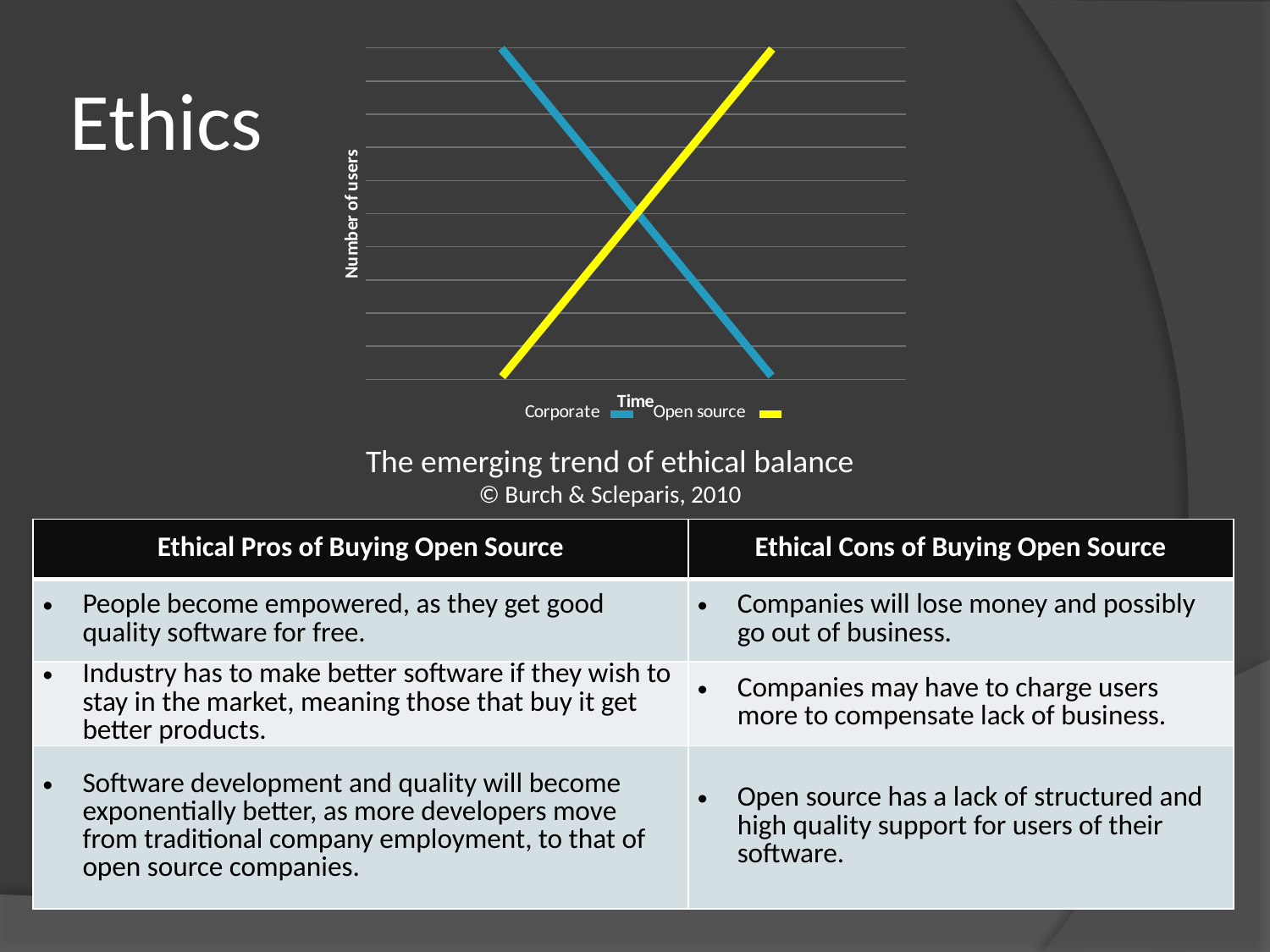
How many series does the chart's legend list? 2 Does the Corporate series rise or fall over time? Fall Which two series are listed in the chart's legend? Corporate and Open source What is the label of the chart's horizontal axis? Time Which series has more users at the end of the time axis, Corporate or Open source? Open source Does the Open source series rise or fall over time? Rise What is the label of the chart's vertical axis? Number of users Which series has more users at the start of the time axis, Corporate or Open source? Corporate What kind of chart is shown on the slide? Line chart